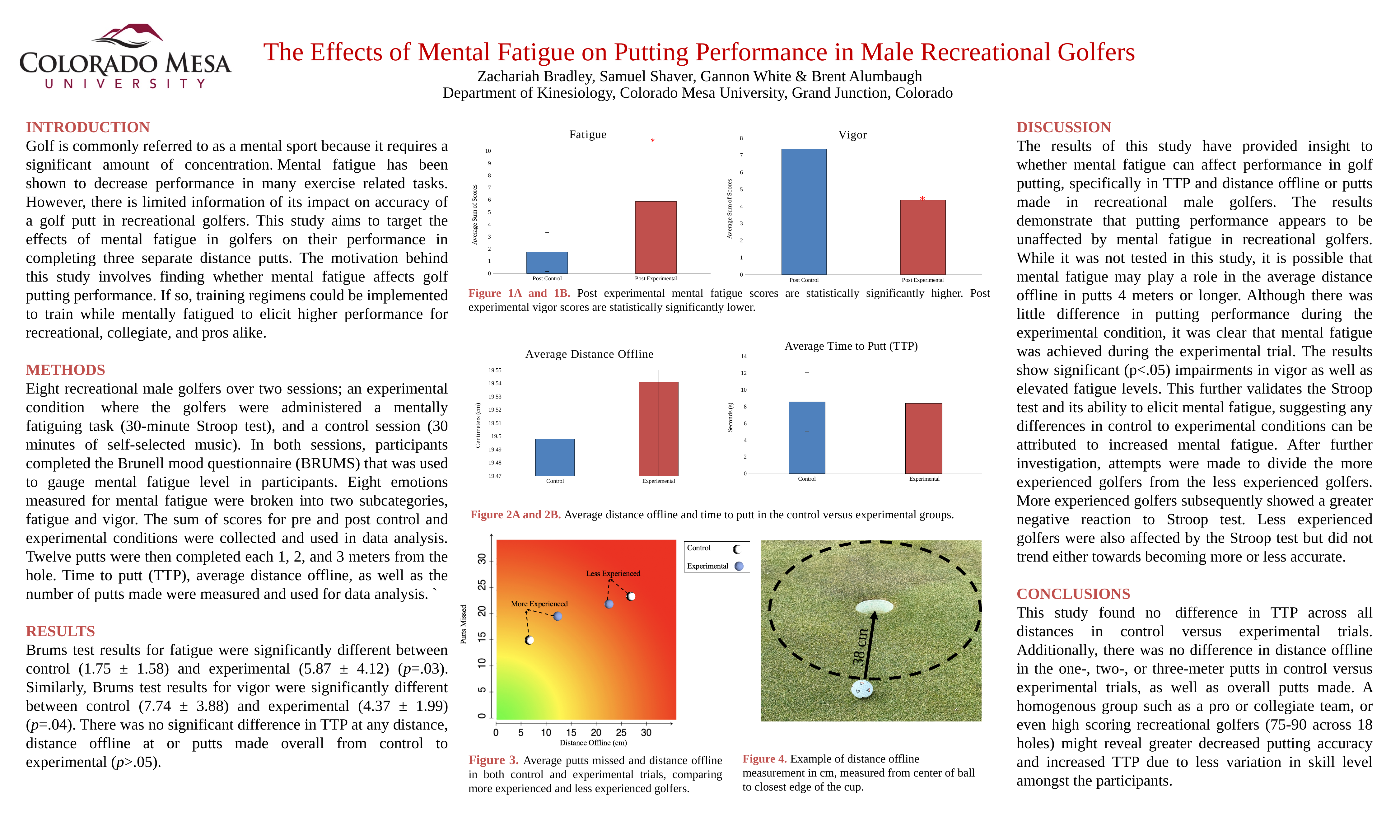
In the Fatigue chart, is the value for Post Control greater or less than 3? less What is the y-axis label of the Average Time to Putt (TTP) chart? Seconds (s) What kind of chart is the Fatigue chart? bar chart In the Vigor chart, is the value for Post Control greater or less than 6? greater In the Vigor chart, is the value for Post Experimental greater or less than 5? less In the Vigor chart, which category has the lowest value? Post Experimental How many series does the legend of the Figure 3 scatter chart list? 2 In the Average Distance Offline chart, which category has the higher value, Control or Experimental? Experimental How many categories are shown in the Fatigue chart? 2 In the Fatigue chart, which category has the higher value, Post Control or Post Experimental? Post Experimental